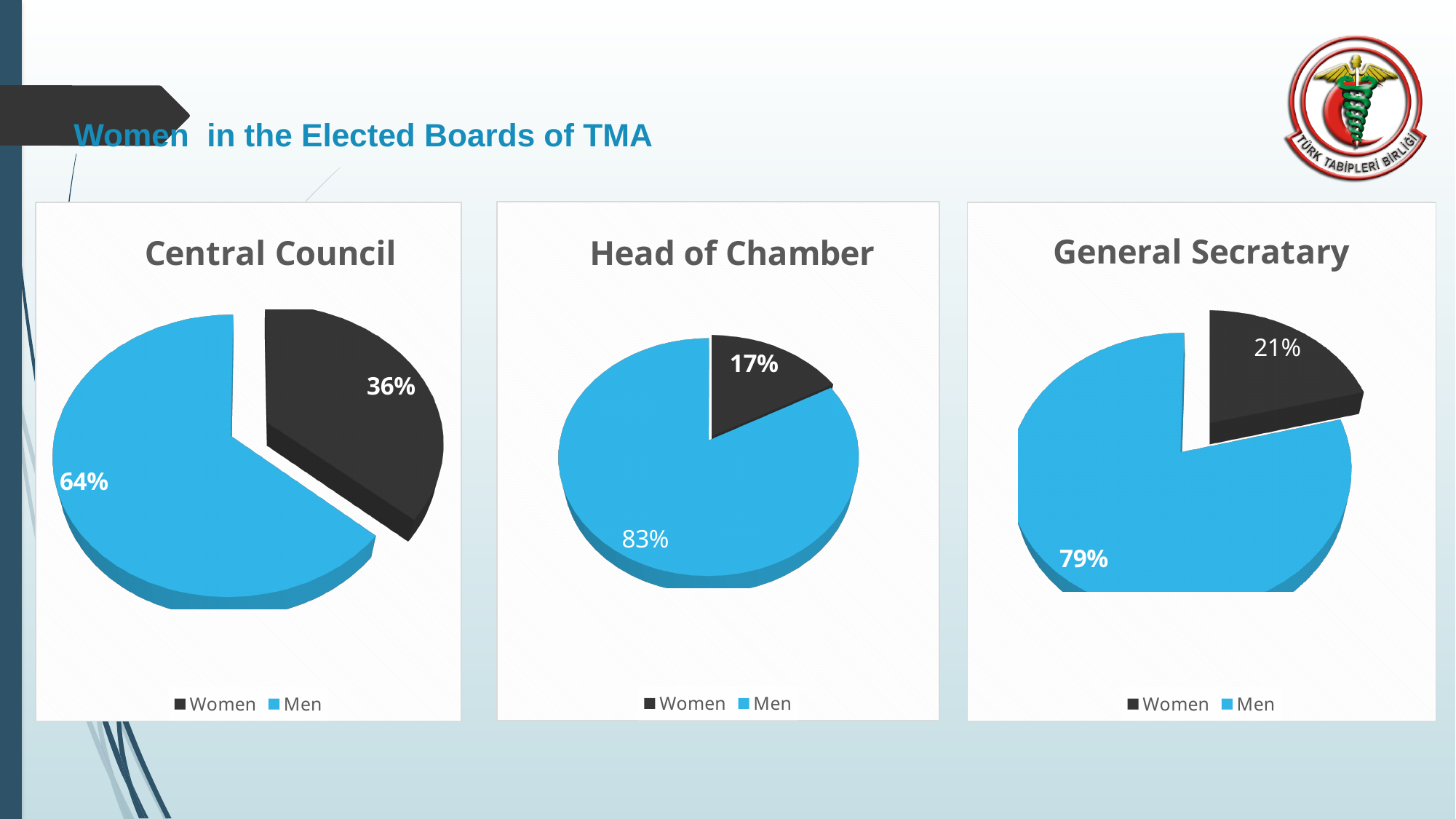
What type of chart is the Central Council chart? Pie chart In the General Secratary chart, which colour represents Women? Dark grey How many entries does the legend of the Head of Chamber chart list? 2 In the Head of Chamber chart, what percentage is labelled for Women? 17% In the Head of Chamber chart, which slice is the smallest? Women In the General Secratary chart, what share of the pie is Women? 21% In the Central Council chart, which slice is larger, Women or Men? Men In the General Secratary chart, what share of the pie is Men? 79% In the Central Council chart, what share of the pie is Women? 36% In the Head of Chamber chart, what percentage is labelled for Men? 83% In the General Secratary chart, what is the difference between the Men and Women percentages? 58% In the Central Council chart, what share of the pie is Men? 64%